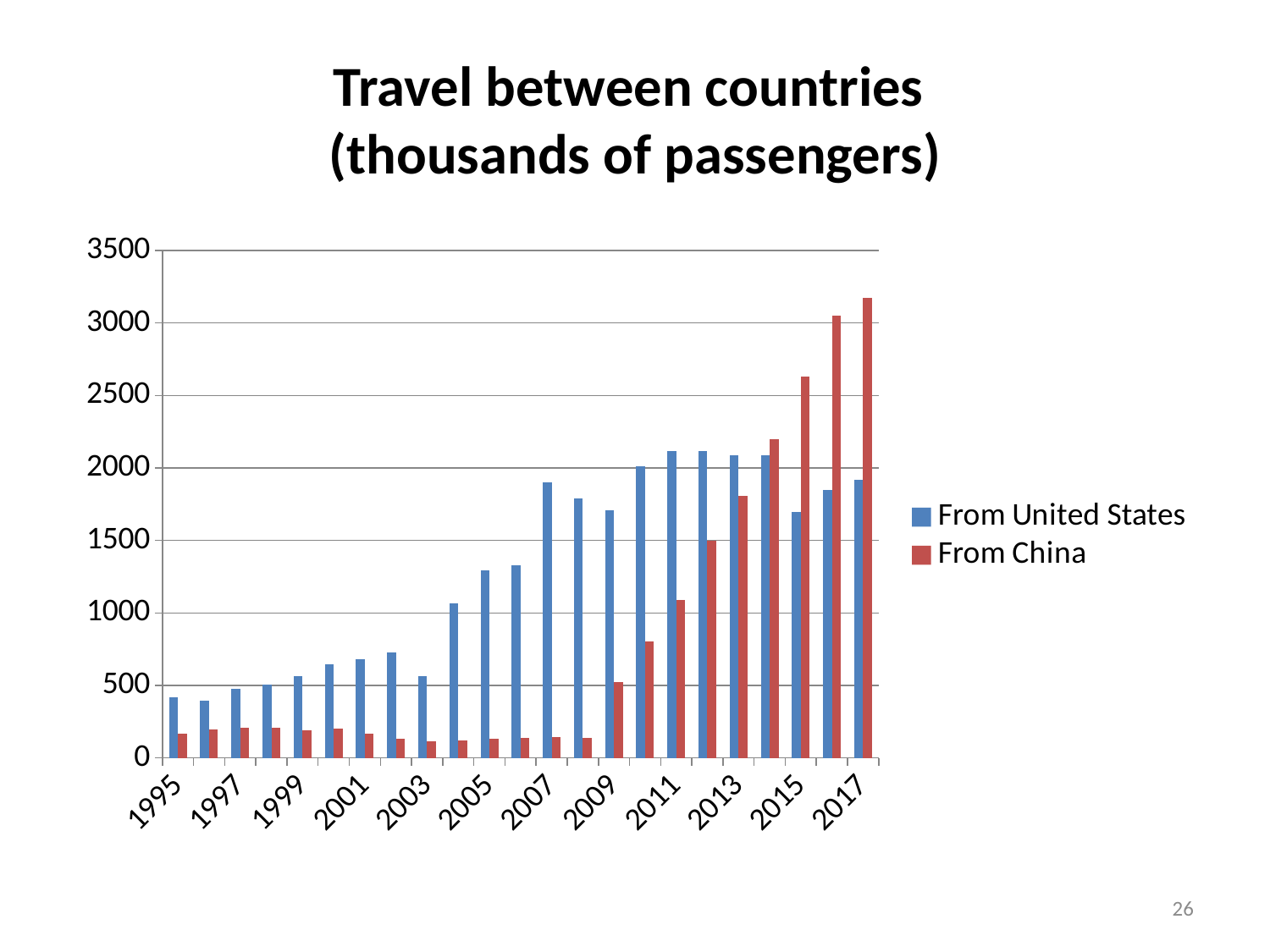
How many series does the legend list? 2 Is the value for From China in 2015 greater or less than 2500? greater Is the value for From United States in 2017 greater or less than 2000? less Is the value for From United States in 2007 greater or less than 1500? greater In 2017, which series has the larger value, From United States or From China? From China In which year is the From China series highest? 2017 What kind of chart is shown on the slide? bar chart In 2009, which series has the larger value, From United States or From China? From United States What are the two series named in the legend? From United States, From China What is the title of the chart? Travel between countries (thousands of passengers)